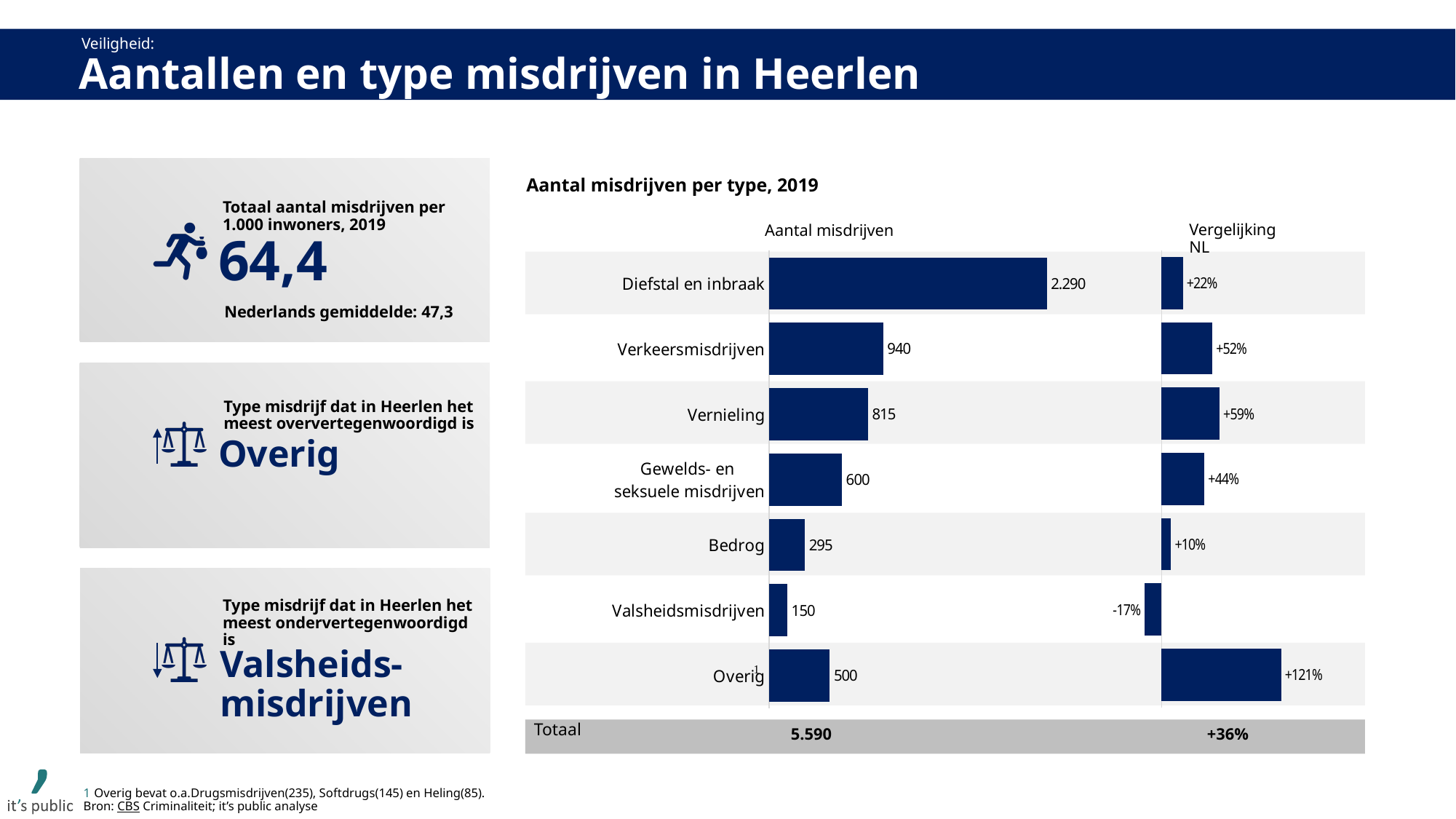
In the chart 'Aantal misdrijven per type, 2019', what is the Totaal Aantal misdrijven shown? 5.590 In the chart 'Aantal misdrijven per type, 2019', which crime type has the lowest Vergelijking NL percentage? Valsheidsmisdrijven In the chart 'Aantal misdrijven per type, 2019', what is the Vergelijking NL value for Vernieling? +59% How many crime types (excluding the Totaal row) are shown in the chart 'Aantal misdrijven per type, 2019'? 7 In the chart 'Aantal misdrijven per type, 2019', which crime type has the highest Vergelijking NL percentage? Overig In the chart 'Aantal misdrijven per type, 2019', what is the Aantal misdrijven for Diefstal en inbraak? 2.290 What kind of chart is 'Aantal misdrijven per type, 2019'? Bar chart In the chart 'Aantal misdrijven per type, 2019', what is the Aantal misdrijven for Gewelds- en seksuele misdrijven? 600 In the chart 'Aantal misdrijven per type, 2019', which has a larger Aantal misdrijven: Bedrog or Overig? Overig In the chart 'Aantal misdrijven per type, 2019', which crime type has the lowest Aantal misdrijven? Valsheidsmisdrijven In the chart 'Aantal misdrijven per type, 2019', what is the difference in Aantal misdrijven between Verkeersmisdrijven and Vernieling? 125 In the chart 'Aantal misdrijven per type, 2019', which crime type has the highest Aantal misdrijven? Diefstal en inbraak